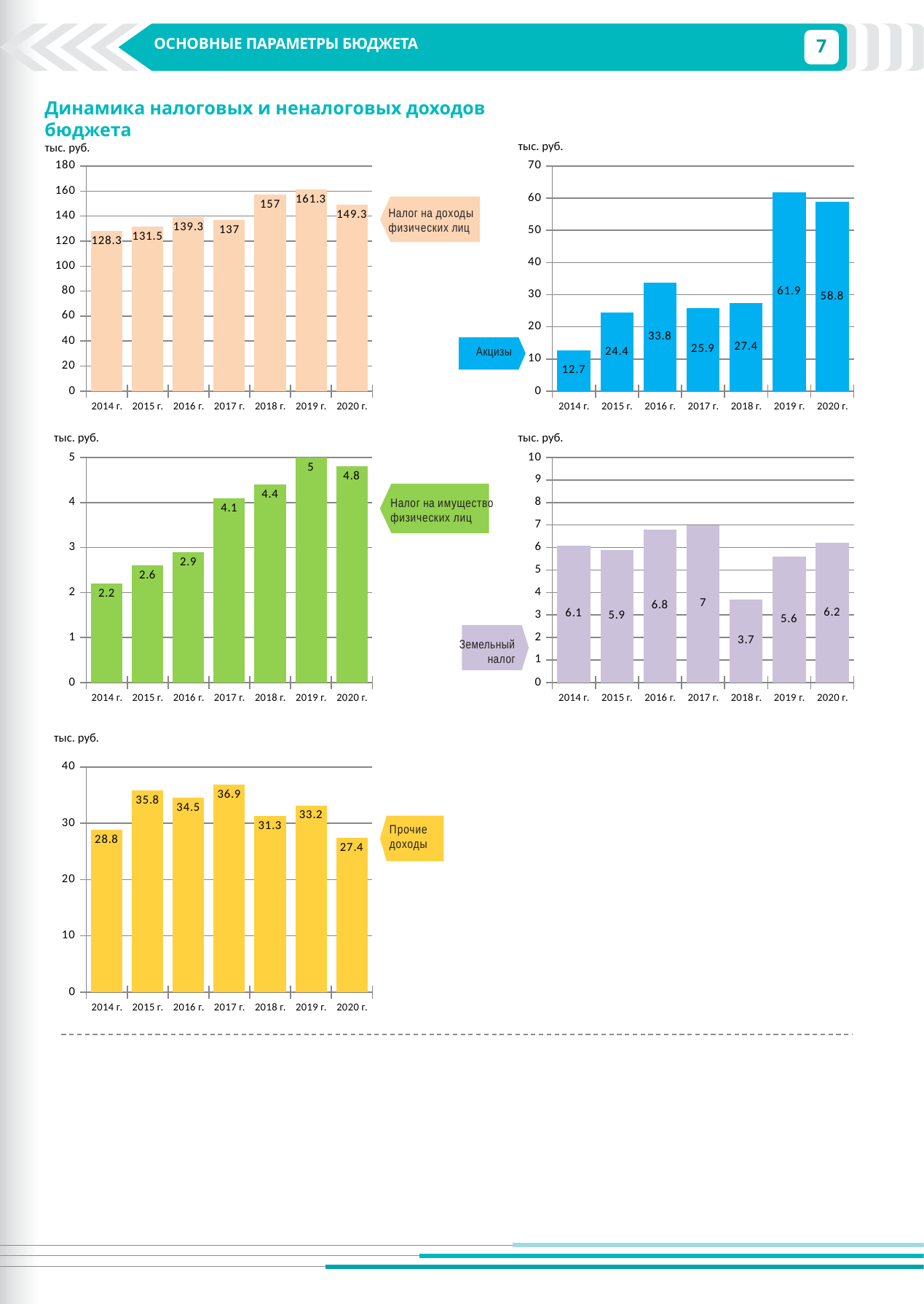
In the 'Земельный налог' chart (middle right), which year has the lowest value? 2018 г. In the 'Земельный налог' chart (middle right), which is larger, the value for 2016 г. or 2020 г.? 2016 г. In the 'Прочие доходы' chart (bottom left), what is the value for 2017 г.? 36.9 In the 'Налог на доходы физических лиц' chart (top left), which year has the highest value? 2019 г. In the 'Акцизы' chart (top right), what is the difference between the values for 2019 г. and 2020 г.? 3.1 In the 'Налог на имущество физических лиц' chart (middle left), do the values generally rise or fall from 2014 г. to 2019 г.? rise What type of chart is the 'Прочие доходы' chart (bottom left)? bar chart In the 'Прочие доходы' chart (bottom left), how many years are shown on the x axis? 7 In the 'Налог на имущество физических лиц' chart (middle left), what is the value for 2017 г.? 4.1 In the 'Акцизы' chart (top right), what is the value for 2014 г.? 12.7 In the 'Налог на доходы физических лиц' chart (top left), what is the value for 2018 г.? 157 In the 'Акцизы' chart (top right), which year has the lowest value? 2014 г.